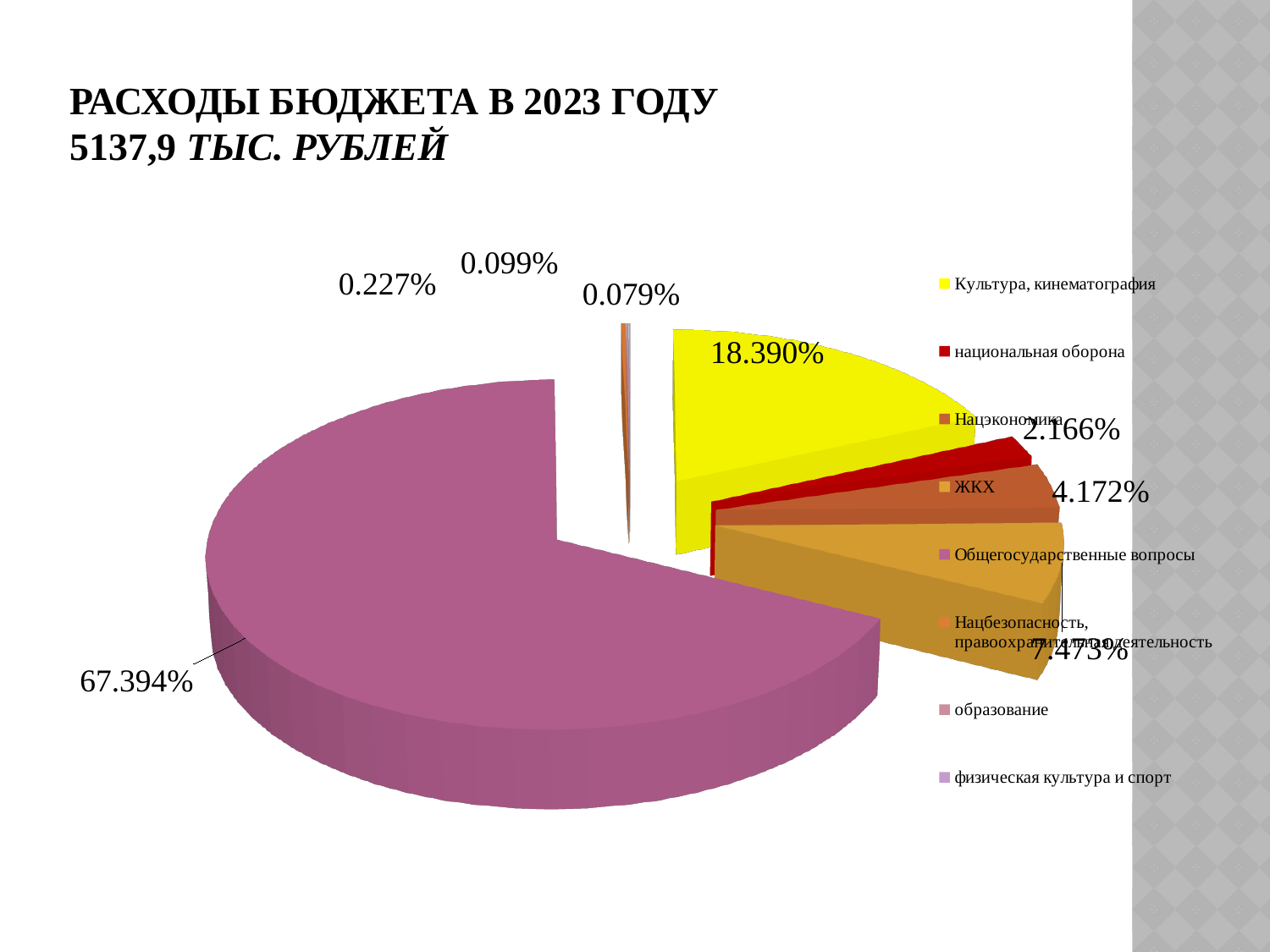
Which slice is larger: Культура, кинематография or ЖКХ? Культура, кинематография What percentage share does the slice for национальная оборона have? 2.166% What percentage share does the slice for Нацэкономика have? 4.172% What is the difference in percentage points between the Культура, кинематография slice and the ЖКХ slice? 10.917% What percentage share does the slice for Культура, кинематография have? 18.390% Which category has the largest slice of the pie? Общегосударственные вопросы What percentage share does the slice for Общегосударственные вопросы have? 67.394% What is the smallest percentage value labelled on the pie chart? 0.079% How many categories does the legend list? 8 What type of chart is shown on the slide? Pie chart What is the title of the slide above the chart? РАСХОДЫ БЮДЖЕТА В 2023 ГОДУ 5137,9 ТЫС. РУБЛЕЙ What percentage share does the slice for ЖКХ have? 7.473%